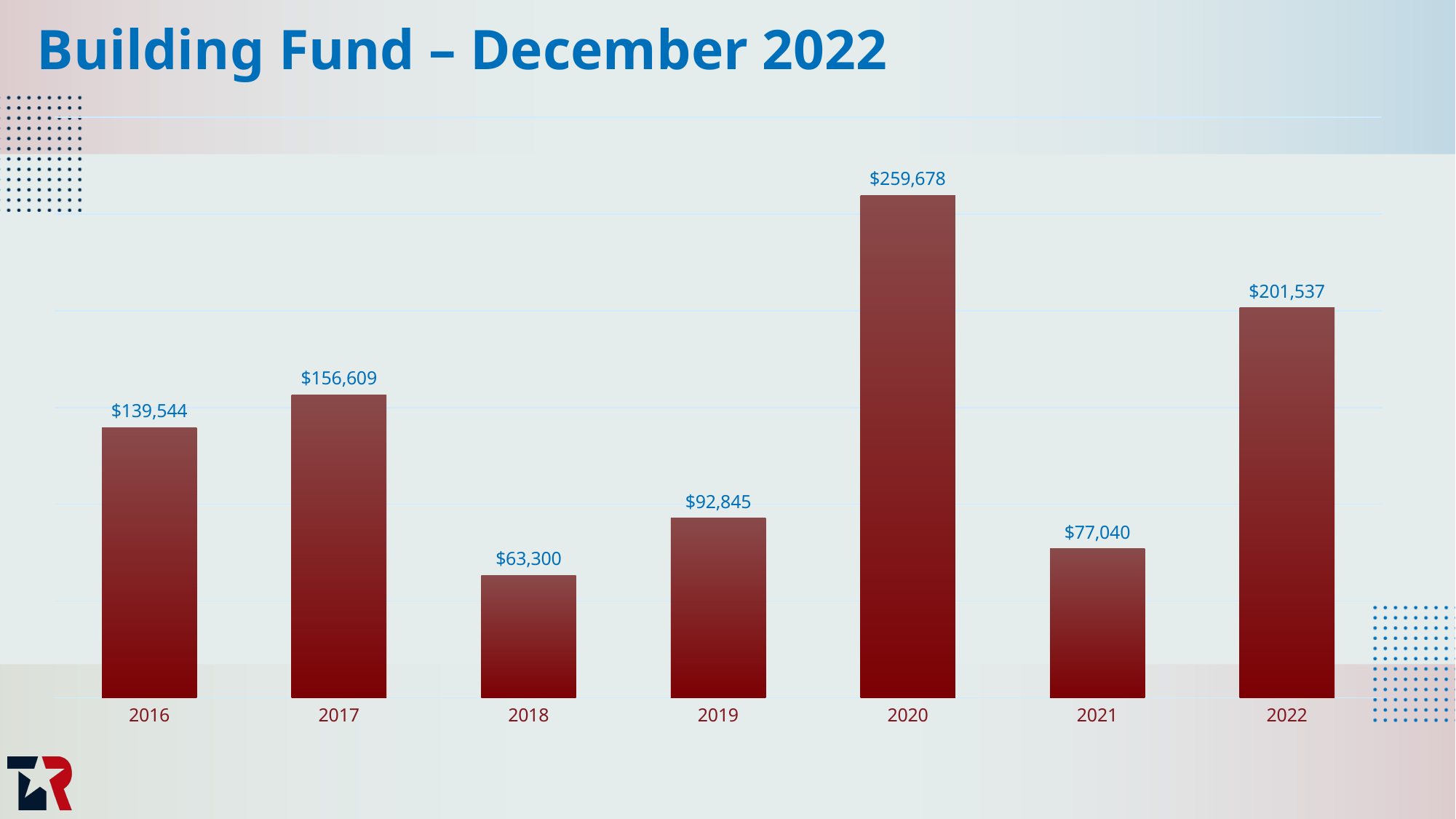
What is the value for 2018? $63,300 What is the difference between the values for 2017 and 2016? $17,065 What kind of chart is shown on the slide? Bar chart What is the value for 2021? $77,040 Which year has the highest value? 2020 What is the title of the slide? Building Fund – December 2022 What is the difference between the values for 2020 and 2022? $58,141 What is the value for 2022? $201,537 Which is larger, the value for 2019 or the value for 2021? 2019 How many years are shown on the chart? 7 What is the value for 2020? $259,678 Which year has the lowest value? 2018